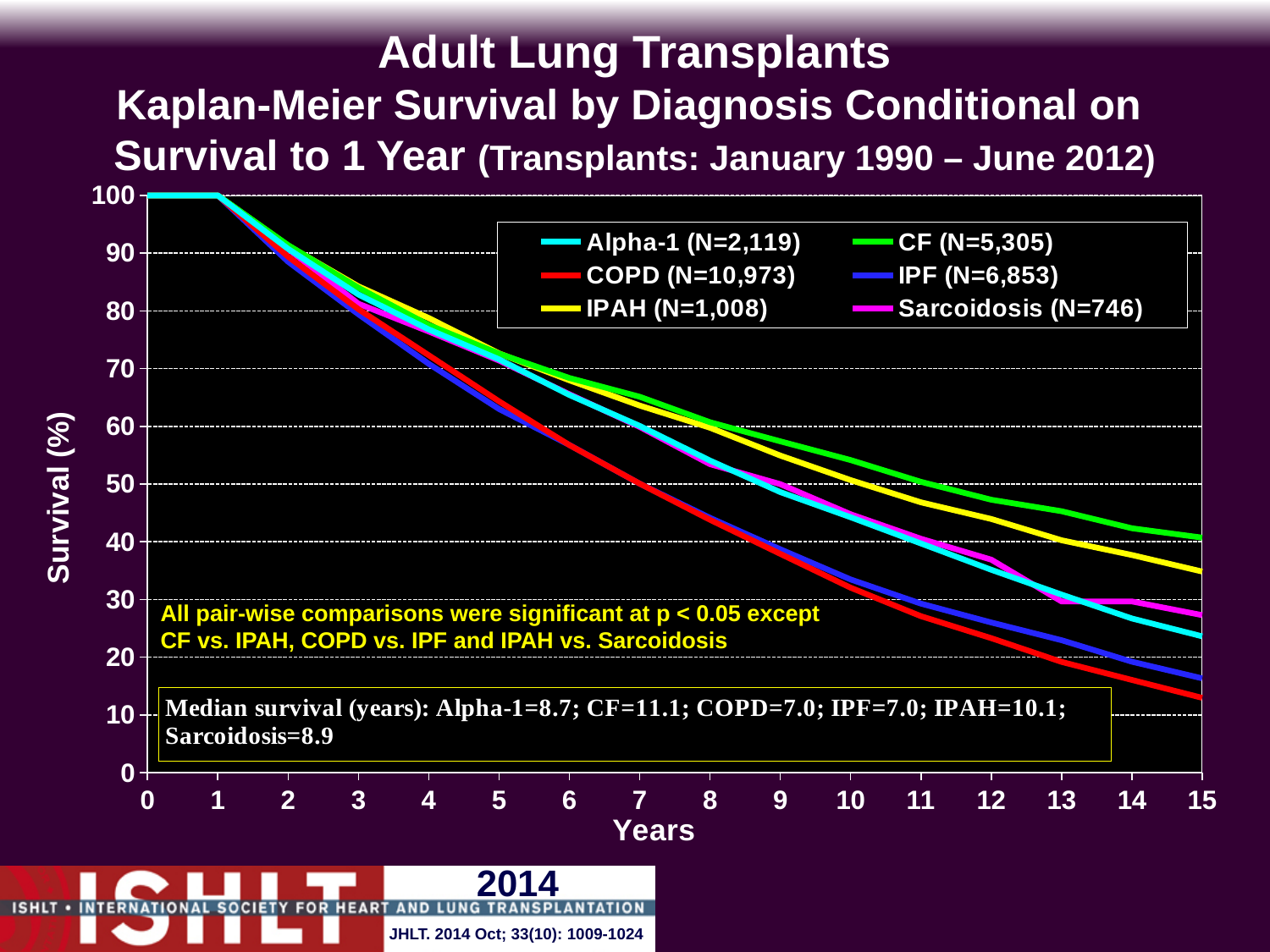
According to the legend, what is the N for Sarcoidosis? 746 Is the survival for COPD at 15 years greater or less than 20%? less What type of chart is shown on the slide? line chart Which diagnosis group has the lowest survival at 15 years? COPD According to the legend, what is the N for COPD? 10,973 Is the survival for CF at 10 years greater or less than 50%? greater What is the difference between the median survival of CF and COPD, in years? 4.1 What is the median survival in years for CF, as stated on the slide? 11.1 What is the median survival in years for IPAH, as stated on the slide? 10.1 How many series does the legend list? 6 Do the survival curves rise or fall as years increase? fall Which diagnosis group has the highest survival at 15 years? CF